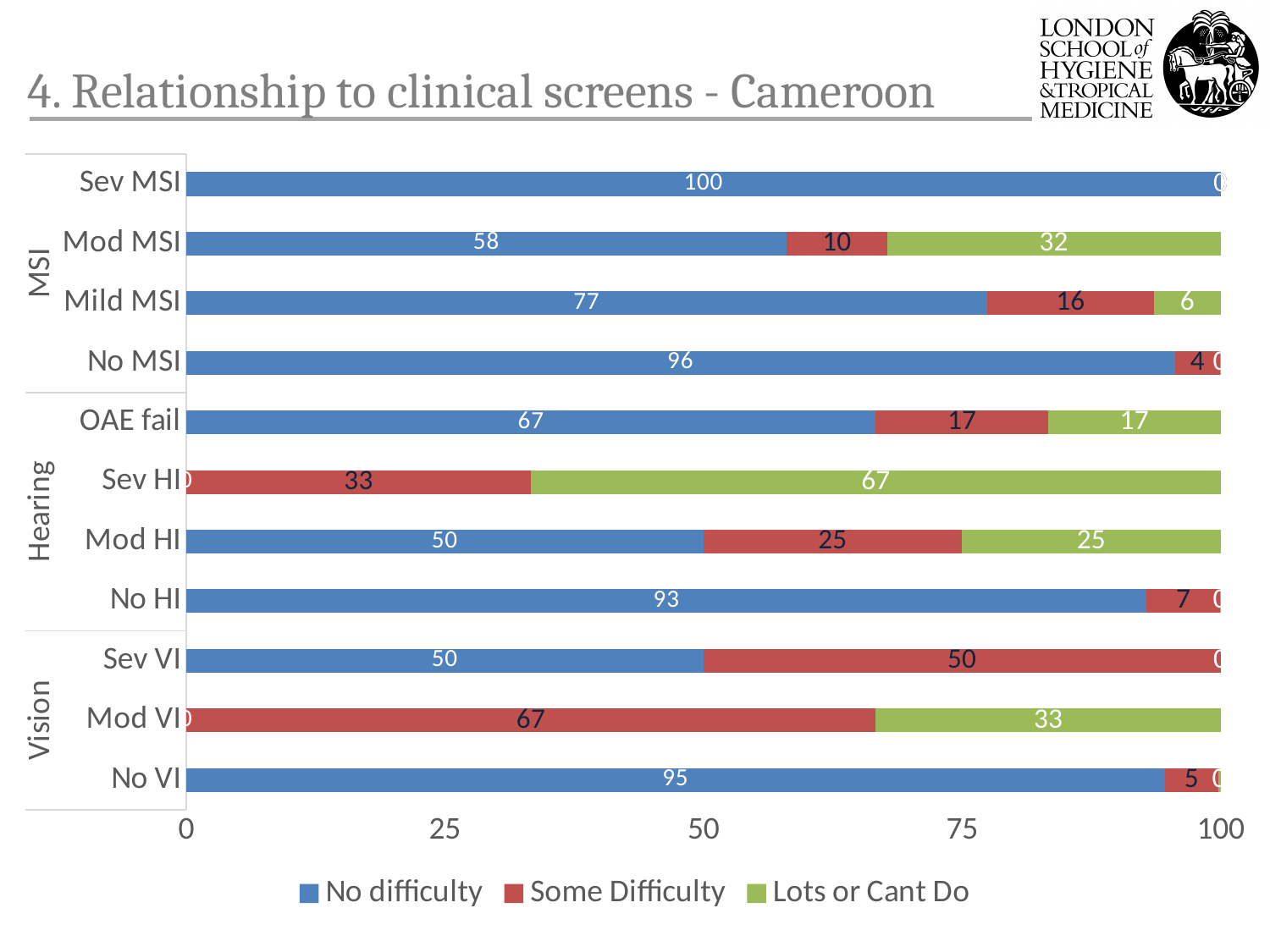
What is the 'Lots or Cant Do' value for OAE fail? 17 What is the 'Lots or Cant Do' value for Sev HI? 67 Which is larger: the 'Lots or Cant Do' value for Mod MSI or for Mod HI? Mod MSI What kind of chart is shown on the slide? Stacked bar chart What is the difference between the 'No difficulty' values for No MSI and Mod MSI? 38 What is the 'Some Difficulty' value for Mild MSI? 16 What is the 'No difficulty' value for Mod MSI? 58 How many series does the legend list? 3 Which category has the highest 'No difficulty' value? Sev MSI Which colour represents 'Some Difficulty' in the legend? Red Which category has the highest 'Some Difficulty' value? Mod VI How many categories are shown on the y axis? 11